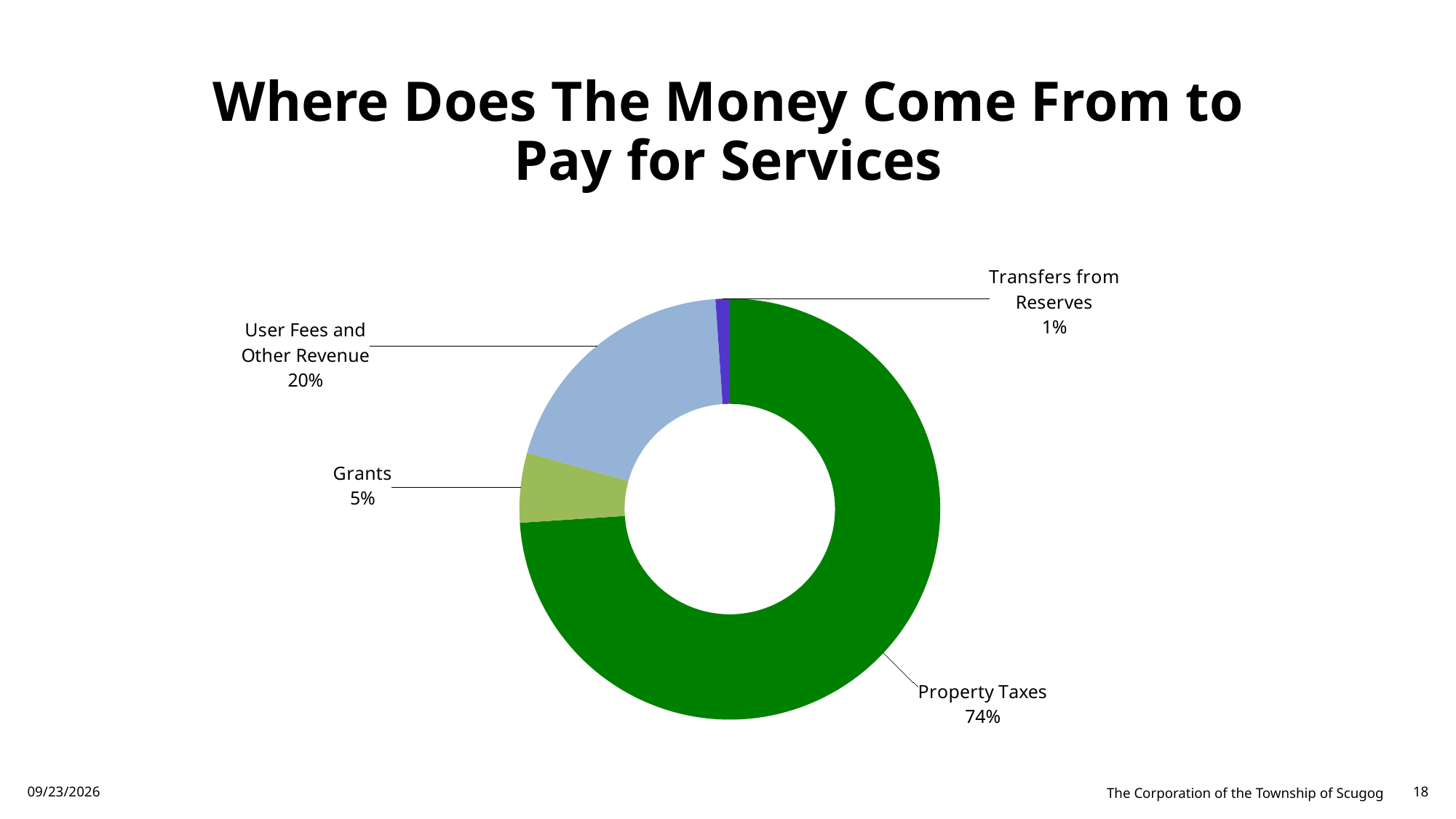
What is the combined share of Grants and Transfers from Reserves? 6% Which source provides the smallest share of the money? Transfers from Reserves What kind of chart is shown on the slide? Pie chart (doughnut) What share of the money comes from Transfers from Reserves? 1% What share of the money comes from User Fees and Other Revenue? 20% What share of the money comes from Property Taxes? 74% How many percentage points larger is the Property Taxes share than the User Fees and Other Revenue share? 54 How many revenue sources are shown in the chart? 4 Which source provides the largest share of the money? Property Taxes What is the title of the chart on the slide? Where Does The Money Come From to Pay for Services What share of the money comes from Grants? 5% Which is larger, the share for Grants or the share for Transfers from Reserves? Grants